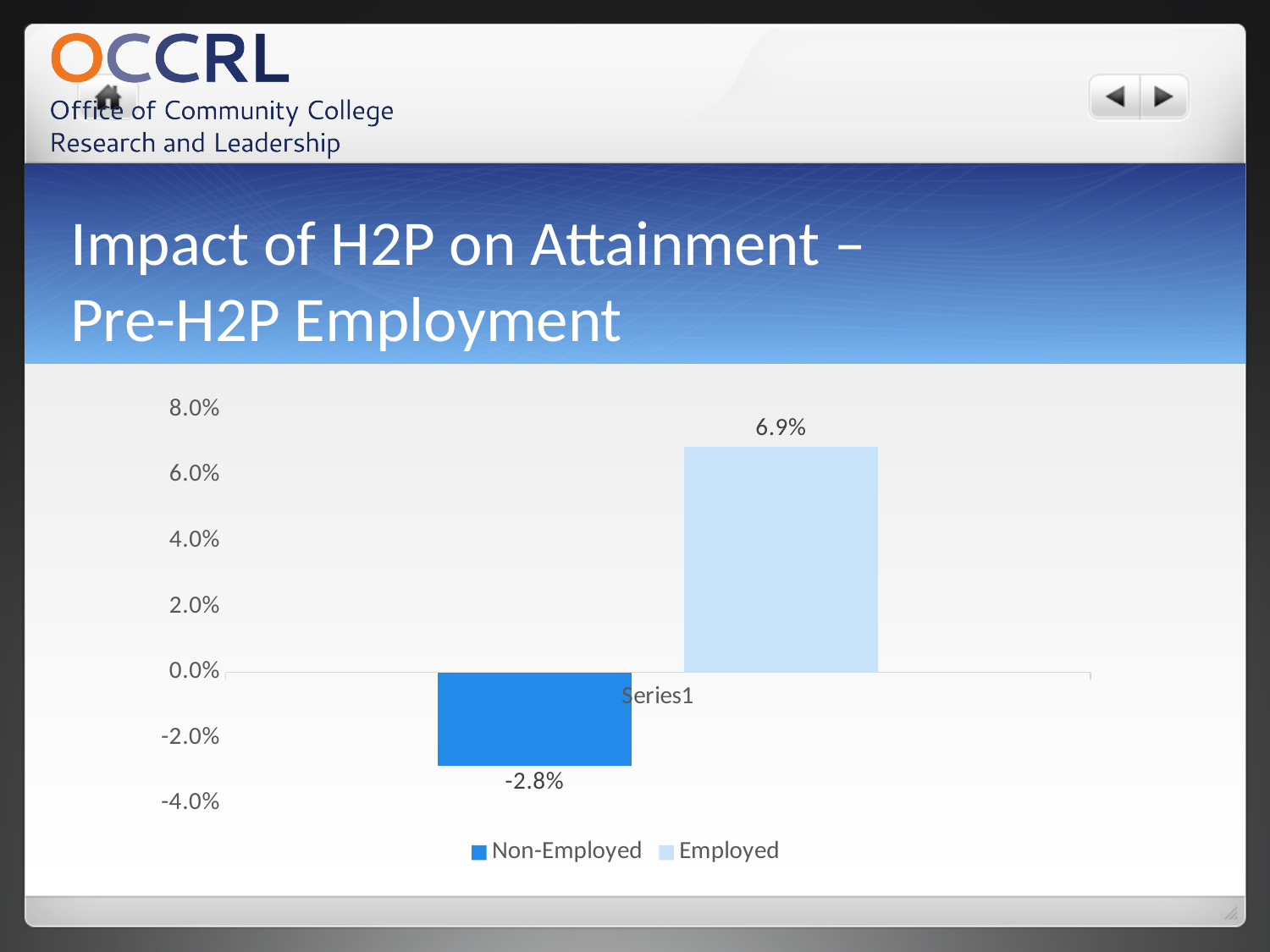
What is the category label shown on the x axis? Series1 Is the value for Non-Employed greater or less than 0.0%? less Which series has the lowest value? Non-Employed What is the highest value shown on the y axis? 8.0% What is the value for Employed? 6.9% Which series has the higher value, Non-Employed or Employed? Employed What is the value for Non-Employed? -2.8% What kind of chart is shown on the slide? Bar chart How many series does the legend list? 2 What is the difference between the Employed and Non-Employed values? 9.7% Is the value for Employed greater or less than 6.0%? greater